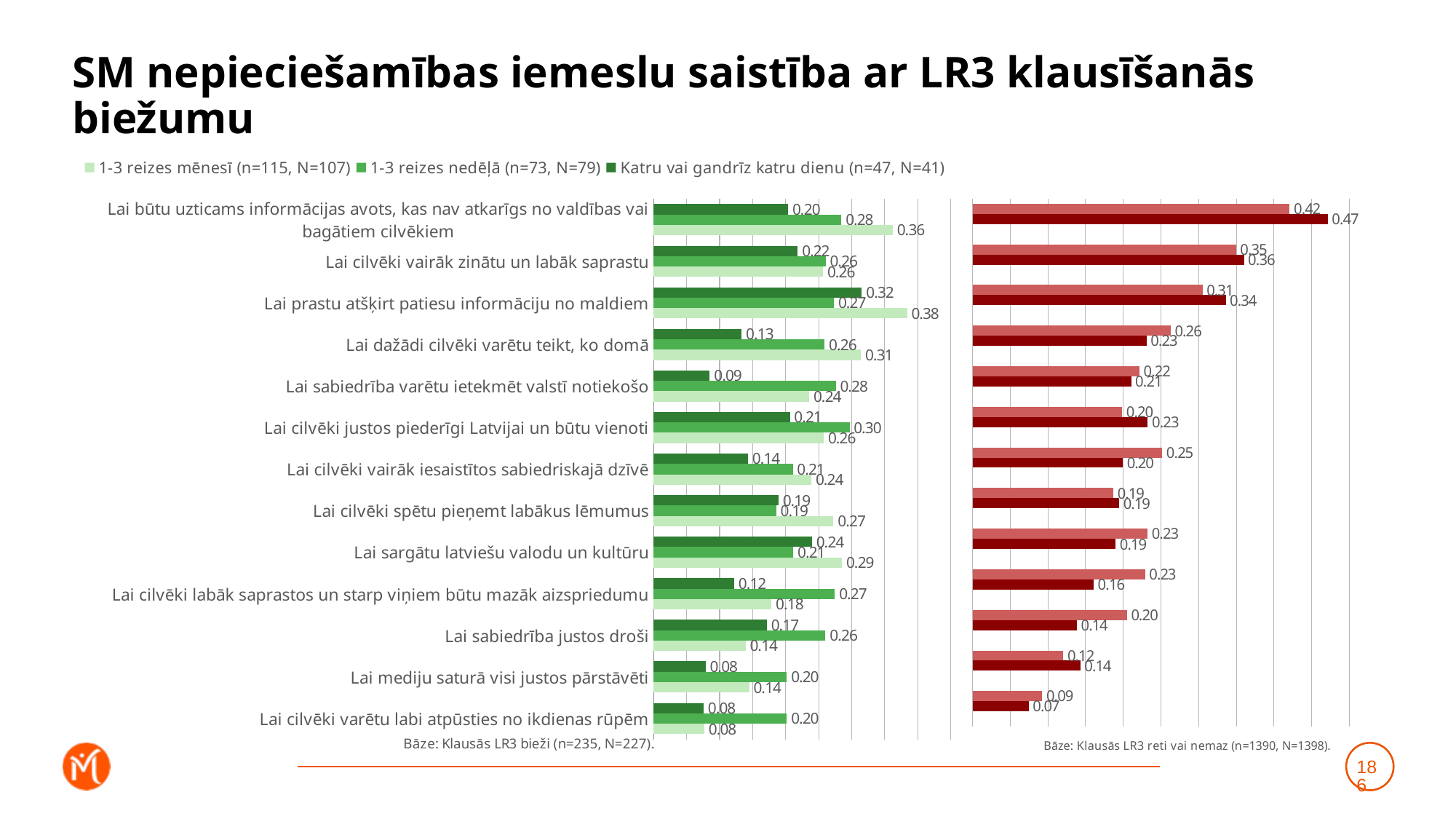
In the left (green) chart, what is the value for 'Katru vai gandrīz katru dienu' for 'Lai sabiedrība varētu ietekmēt valstī notiekošo'? 0.09 How many categories are plotted in the left (green) chart? 13 In the left (green) chart, what is the value for '1-3 reizes mēnesī' for 'Lai prastu atšķirt patiesu informāciju no maldiem'? 0.38 In the left (green) chart, which category has the highest value for '1-3 reizes mēnesī'? Lai prastu atšķirt patiesu informāciju no maldiem How many series does the legend at the top of the slide list? 3 In the right (red) chart, what is the value of the lighter red bar for 'Lai cilvēki varētu labi atpūsties no ikdienas rūpēm'? 0.09 In the left (green) chart, for 'Lai sabiedrība justos droši', which is larger: the '1-3 reizes nedēļā' value or the '1-3 reizes mēnesī' value? 1-3 reizes nedēļā What kind of chart is shown on the left side of the slide? bar chart In the left (green) chart, which category has the highest value for 'Katru vai gandrīz katru dienu'? Lai prastu atšķirt patiesu informāciju no maldiem In the left (green) chart, what is the value for '1-3 reizes nedēļā' for 'Lai cilvēki justos piederīgi Latvijai un būtu vienoti'? 0.30 In the left (green) chart, what is the difference between the '1-3 reizes mēnesī' and 'Katru vai gandrīz katru dienu' values for 'Lai būtu uzticams informācijas avots, kas nav atkarīgs no valdības vai bagātiem cilvēkiem'? 0.16 In the right (red) chart, what is the value of the darker red bar for 'Lai būtu uzticams informācijas avots, kas nav atkarīgs no valdības vai bagātiem cilvēkiem'? 0.47